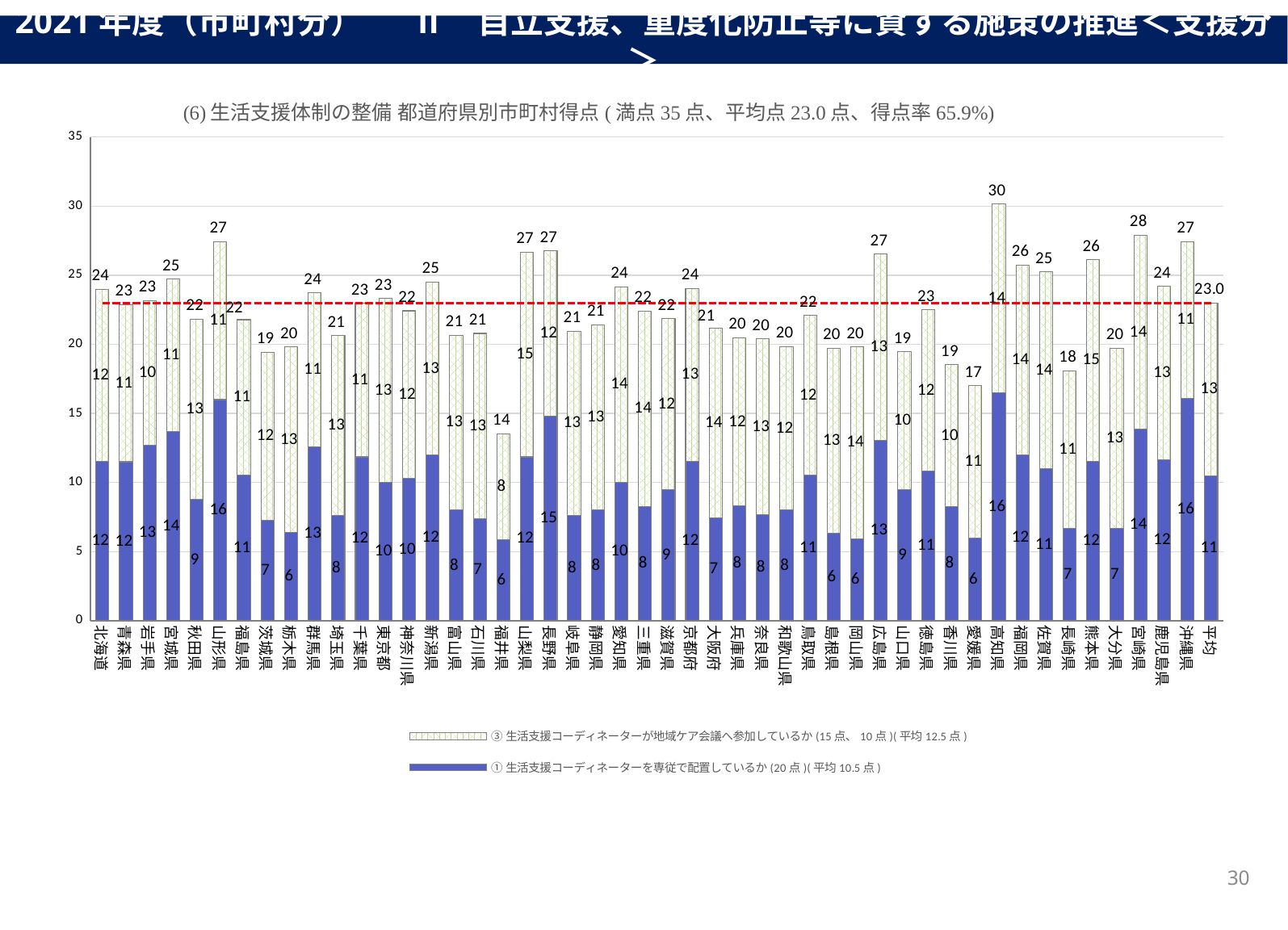
Which prefecture has the highest total score? 高知県 Which has a higher total score, 広島県 or 愛媛県? 広島県 Which prefecture has the lowest total score? 福井県 What is the difference between the total scores of 高知県 and 福井県? 16 Is the total score for 長崎県 greater or less than 20? less What is the value of the ③ series (hatched segment) for 山梨県? 15 How many series does the legend list? 2 What type of chart is shown on the slide? stacked bar chart What is the total score shown for 平均 (average)? 23.0 What is the total score for 宮崎県? 28 What is the value of the ① series (blue segment) for 山形県? 16 What is the maximum score (満点) stated in the chart title? 35 点